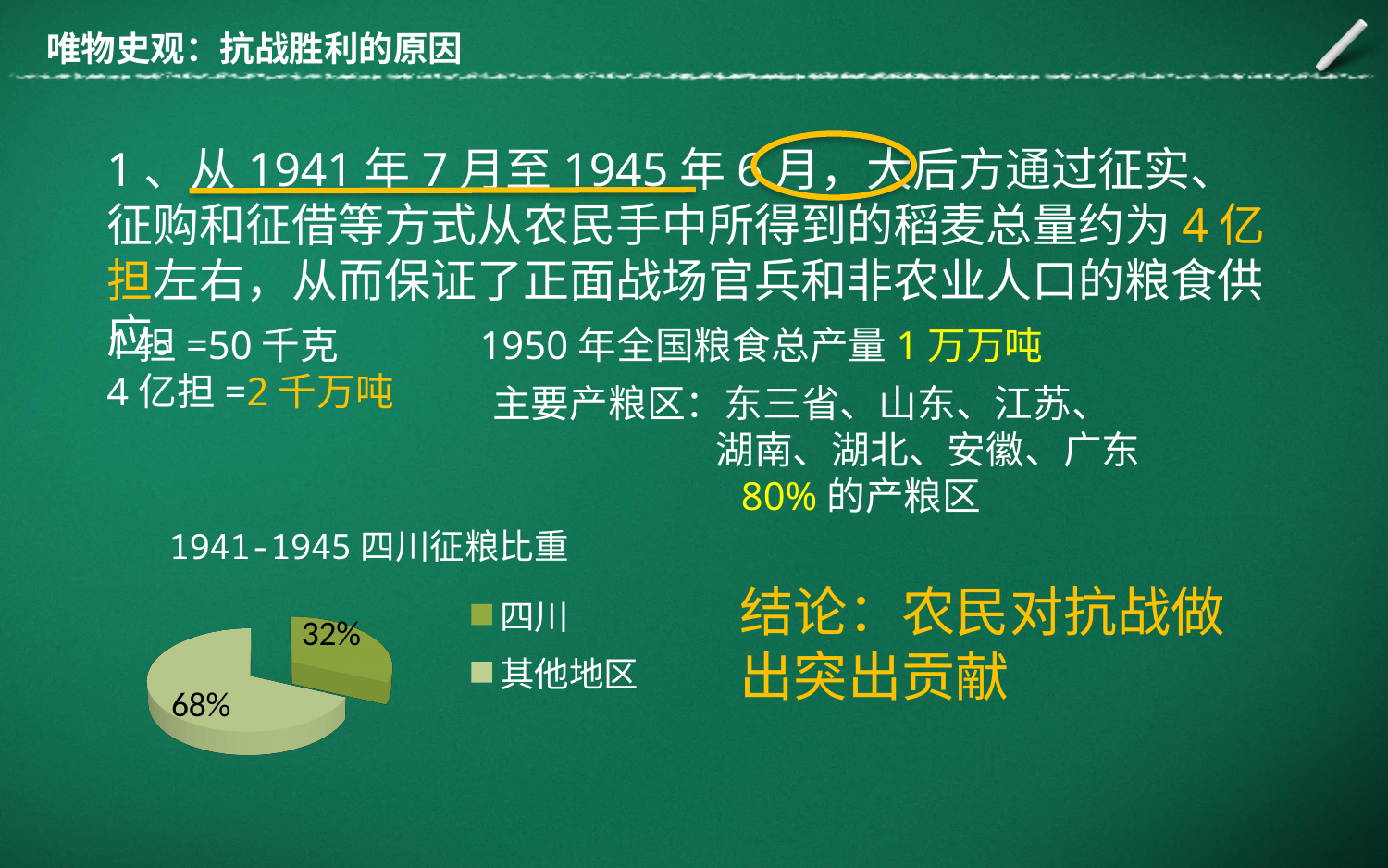
How many slices does the pie chart have? 2 Which slice of the pie chart is the smallest? 四川 What is the difference in percentage points between the 其他地区 slice and the 四川 slice? 36 What is the title of the pie chart? 1941-1945 四川征粮比重 What type of chart is shown on the slide? pie chart Which slice of the pie chart is pulled out (exploded) from the rest of the pie? 四川 Which slice of the pie chart is the largest? 其他地区 How many entries does the legend of the pie chart list? 2 What share of the pie does 四川 account for? 32% What share of the pie does 其他地区 account for? 68% Which is larger, the share for 四川 or the share for 其他地区? 其他地区